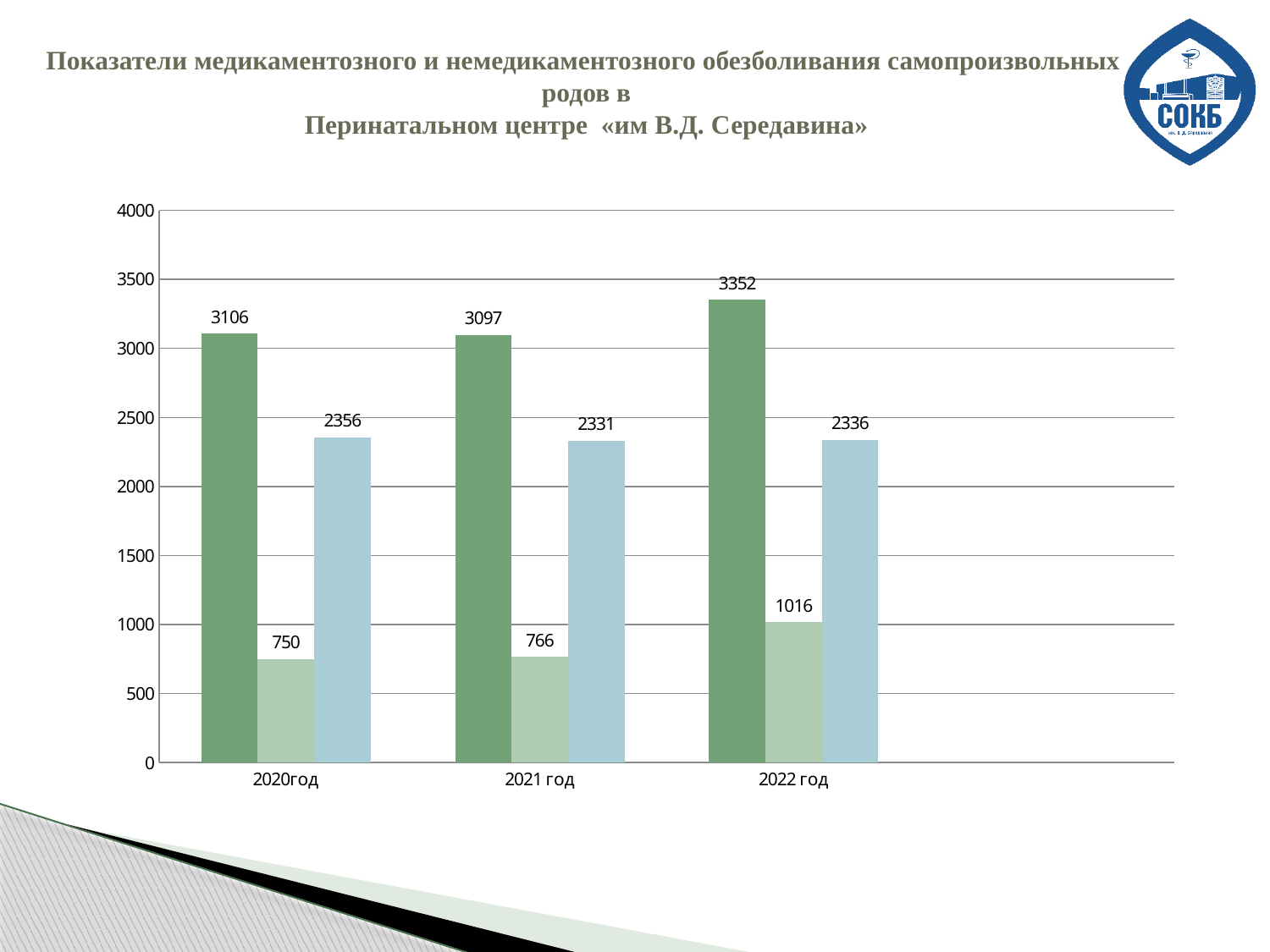
How many year categories are shown on the x axis? 3 What is the value of the light blue bar for 2021 год? 2331 Which is larger: the light blue bar for 2020год or the light blue bar for 2022 год? 2020год Do the light green bar values rise or fall from 2020год to 2022 год? rise What is the value of the dark green bar for 2022 год? 3352 In which year is the dark green bar highest? 2022 год What is the difference between the light green bar values for 2022 год and 2020год? 266 In which year is the light green bar lowest? 2020год What is the value of the light green bar for 2020год? 750 Is the value of the light green bar for 2022 год greater or less than 1000? greater What is the difference between the dark green bar values for 2022 год and 2021 год? 255 What kind of chart is shown on the slide? bar chart